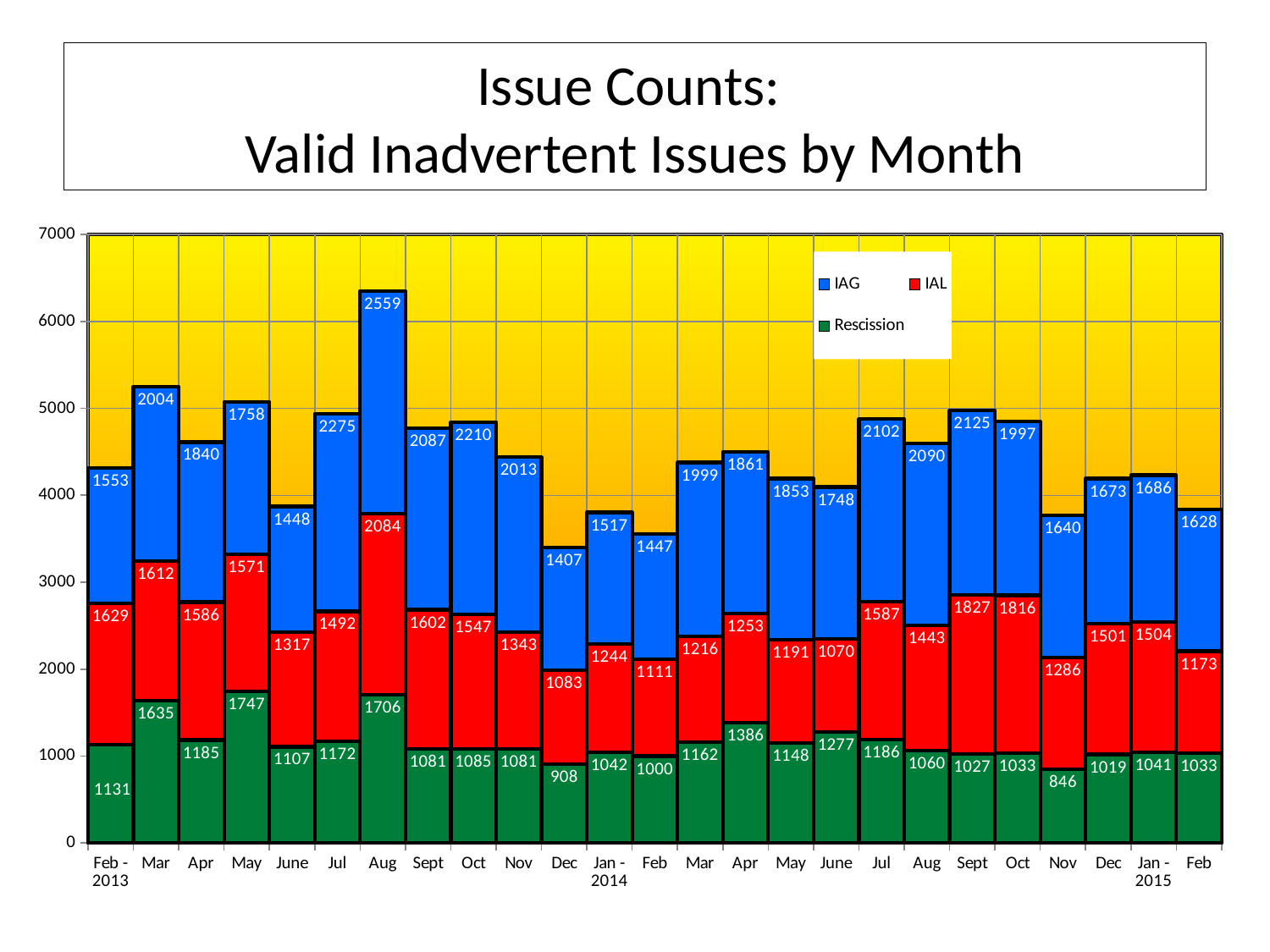
Is the total stacked value for Aug 2013 greater or less than 6000? greater Which is larger, the IAG value for Mar 2013 or the IAG value for Oct 2014? Mar 2013 What kind of chart is shown on the slide? Stacked bar chart How many months are shown on the x axis? 25 What is the Rescission value for Nov 2014? 846 What is the IAG value for Aug 2013? 2559 What is the total of the stacked bar for Dec 2013? 3398 Which month has the lowest Rescission value? Nov 2014 What is the difference between the IAL values for Aug 2013 and Feb 2014? 973 How many series does the legend list? 3 Which month has the highest IAG value? Aug 2013 What is the IAL value for Sept 2014? 1827